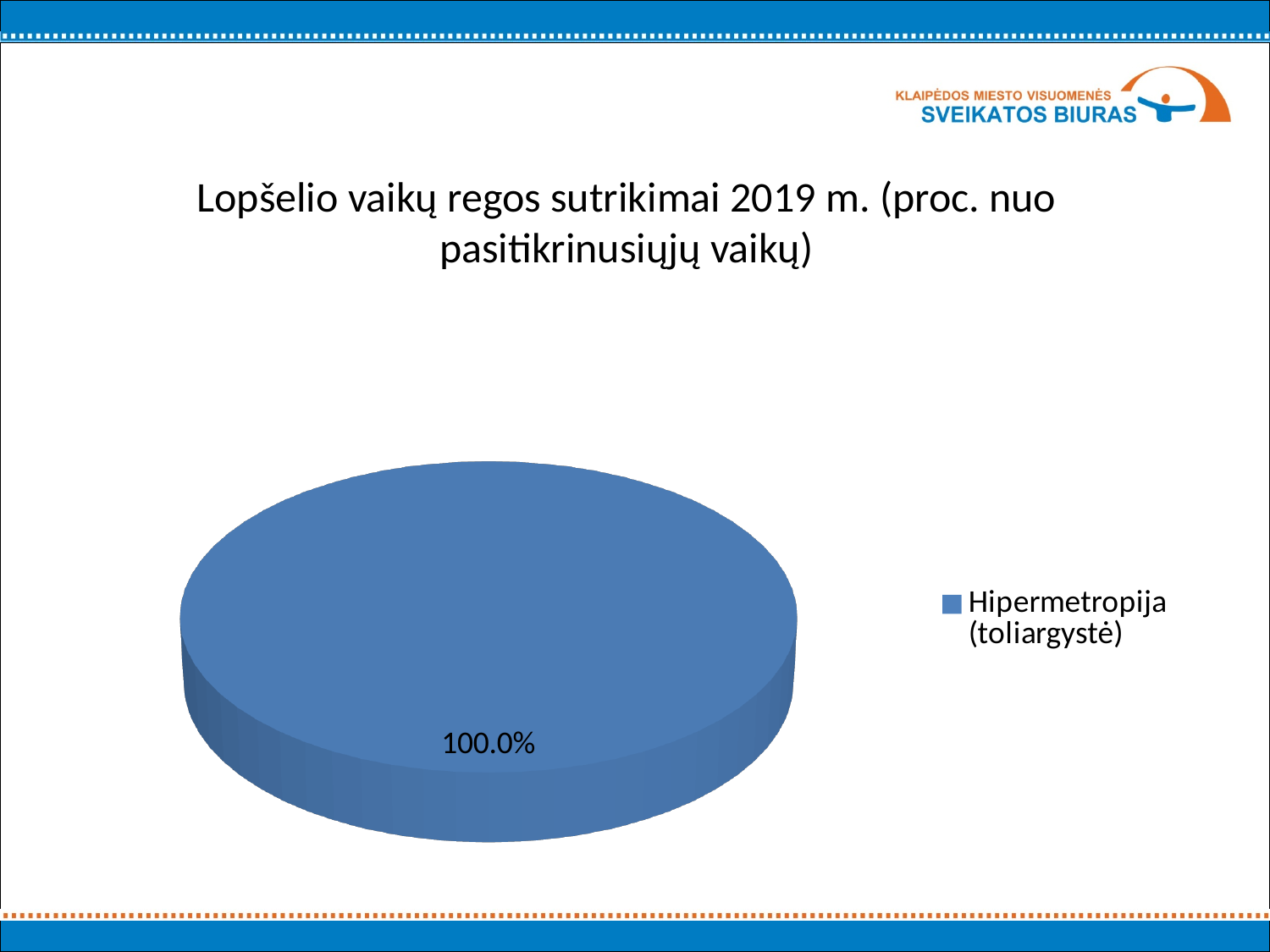
Which year does the chart title refer to? 2019 What is the title of the chart? Lopšelio vaikų regos sutrikimai 2019 m. (proc. nuo pasitikrinusiųjų vaikų) What category is listed in the legend? Hipermetropija (toliargystė) What share of the pie does Hipermetropija (toliargystė) represent? 100.0% What is the value printed on the pie slice? 100.0% How many slices does the pie chart have? 1 How many entries does the legend list? 1 What kind of chart is shown on the slide? pie chart